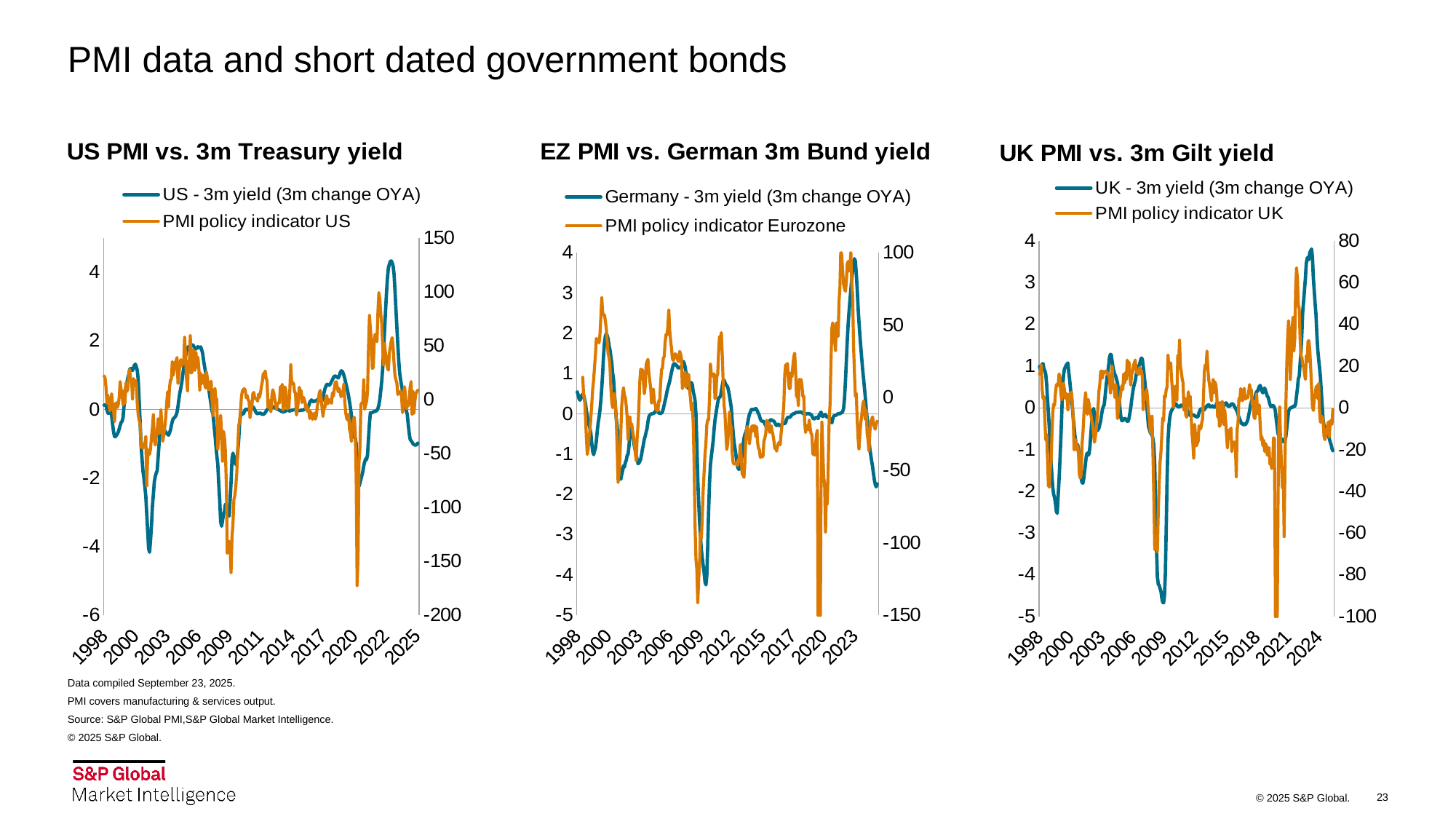
What is the title of the middle chart on the slide? EZ PMI vs. German 3m Bund yield How many series does the legend of the 'UK PMI vs. 3m Gilt yield' chart list? 2 What kind of chart is the 'US PMI vs. 3m Treasury yield' chart? line chart In the 'EZ PMI vs. German 3m Bund yield' chart, is the peak value of the 'Germany - 3m yield (3m change OYA)' series around 2023 greater or less than 3 on the left axis? greater How many charts are shown on the slide? 3 How many series does the legend of the 'EZ PMI vs. German 3m Bund yield' chart list? 2 In the 'UK PMI vs. 3m Gilt yield' chart, is the peak value of the 'UK - 3m yield (3m change OYA)' series around 2023 greater or less than 3 on the left axis? greater In the 'UK PMI vs. 3m Gilt yield' chart, what colour is the 'PMI policy indicator UK' line? orange In the 'US PMI vs. 3m Treasury yield' chart, is the lowest value of the 'US - 3m yield (3m change OYA)' series around 2002 greater or less than -2 on the left axis? less